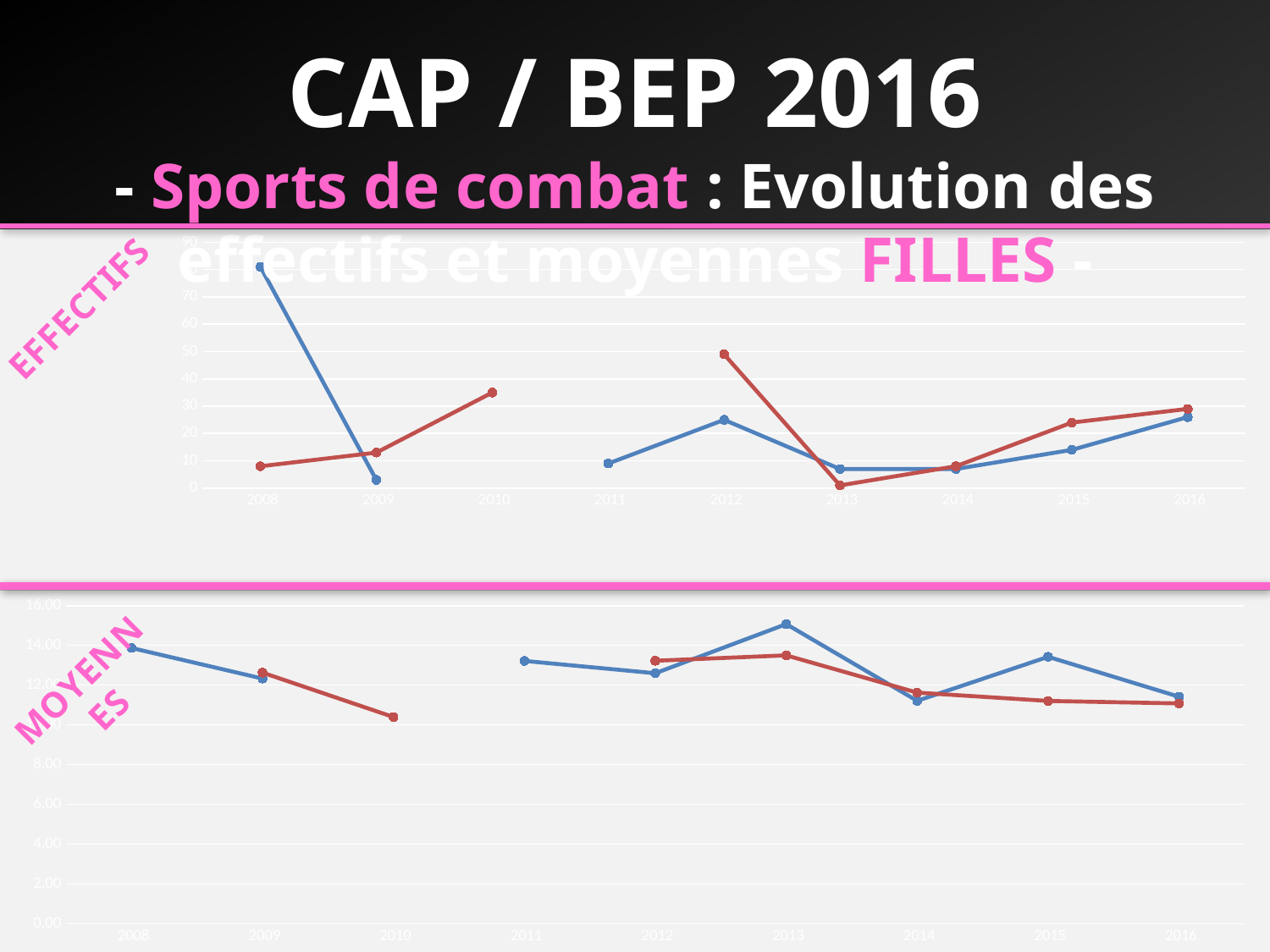
In the bottom MOYENNES chart, is the blue value for 2013 greater or less than 14.00? greater In the top EFFECTIFS chart, in which year does the blue line reach its highest value? 2008 In the top EFFECTIFS chart, which line is higher in 2012, the blue or the red? red What kind of chart is the top chart labelled EFFECTIFS? line chart What kind of chart is the bottom chart labelled MOYENNES? line chart In the top EFFECTIFS chart, is the blue value for 2009 greater or less than 10? less In the top EFFECTIFS chart, is the blue value for 2008 greater or less than 70? greater In the top EFFECTIFS chart, which line is higher in 2008, the blue or the red? blue How many years are shown on the x axis of the top EFFECTIFS chart? 9 In the bottom MOYENNES chart, does the red line rise or fall from 2009 to 2010? fall In the bottom MOYENNES chart, in which year does the blue line reach its highest value? 2013